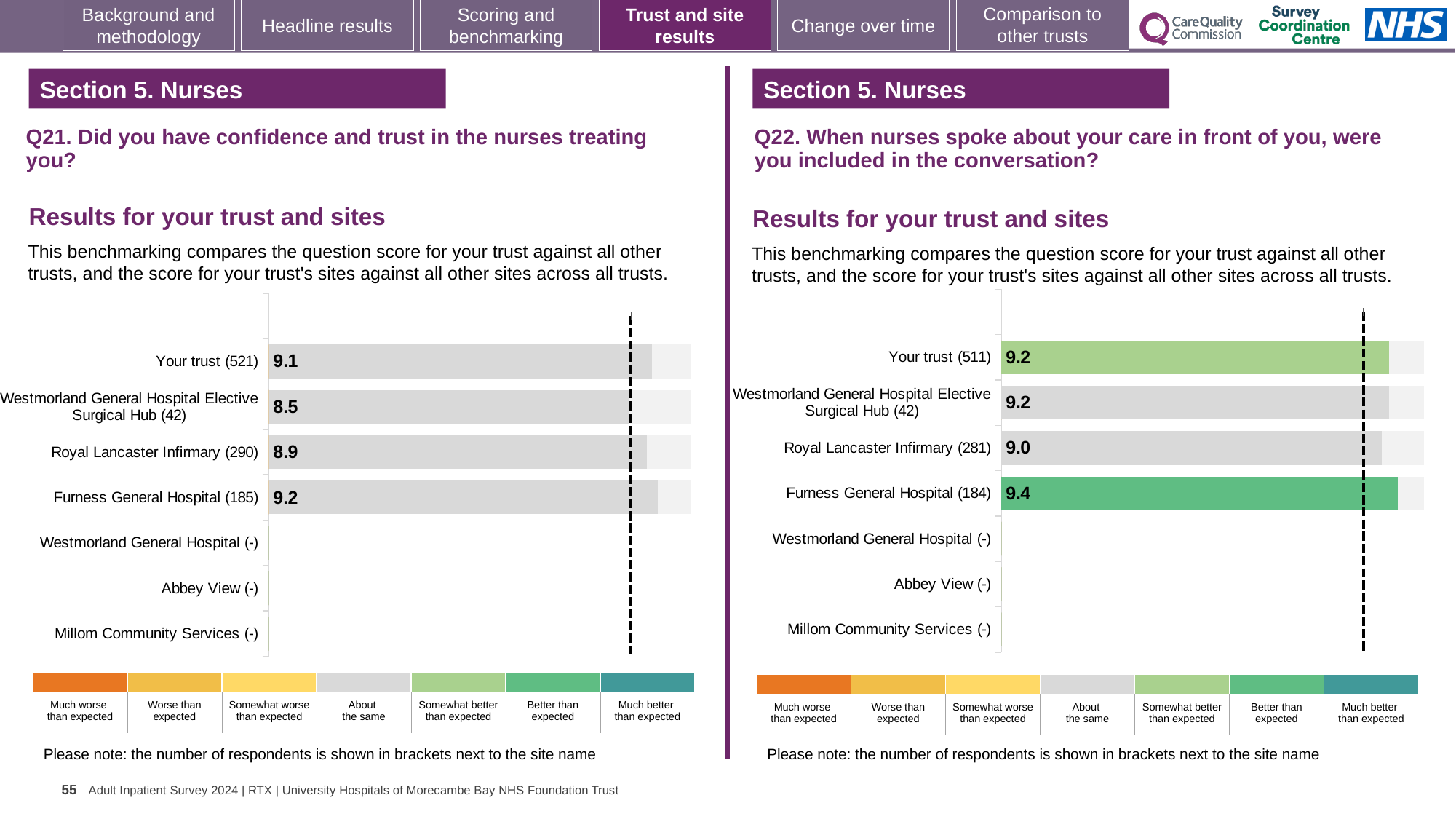
In the Q22 chart on the right, what is the score for Royal Lancaster Infirmary (281)? 9.0 What type of chart is used for the Q22 results on the right? Bar chart In the Q21 chart on the left, what is the score for Your trust (521)? 9.1 How many sites in the Q21 chart on the left have a score shown as (-) with no bar? 3 In the Q21 chart on the left, what is the score for Westmorland General Hospital Elective Surgical Hub (42)? 8.5 In the Q21 chart on the left, which site has the highest score? Furness General Hospital (185) In the Q22 chart on the right, which is larger: the score for Your trust (511) or the score for Furness General Hospital (184)? Furness General Hospital (184) In the Q22 chart on the right, what is the score for Furness General Hospital (184)? 9.4 In the Q21 chart on the left, what is the difference between the scores for Furness General Hospital (185) and Royal Lancaster Infirmary (290)? 0.3 In the Q21 chart on the left, which site has the lowest score? Westmorland General Hospital Elective Surgical Hub (42) In the Q22 chart on the right, which site has the lowest score? Royal Lancaster Infirmary (281) In the Q22 chart on the right, what is the difference between the scores for Furness General Hospital (184) and Royal Lancaster Infirmary (281)? 0.4